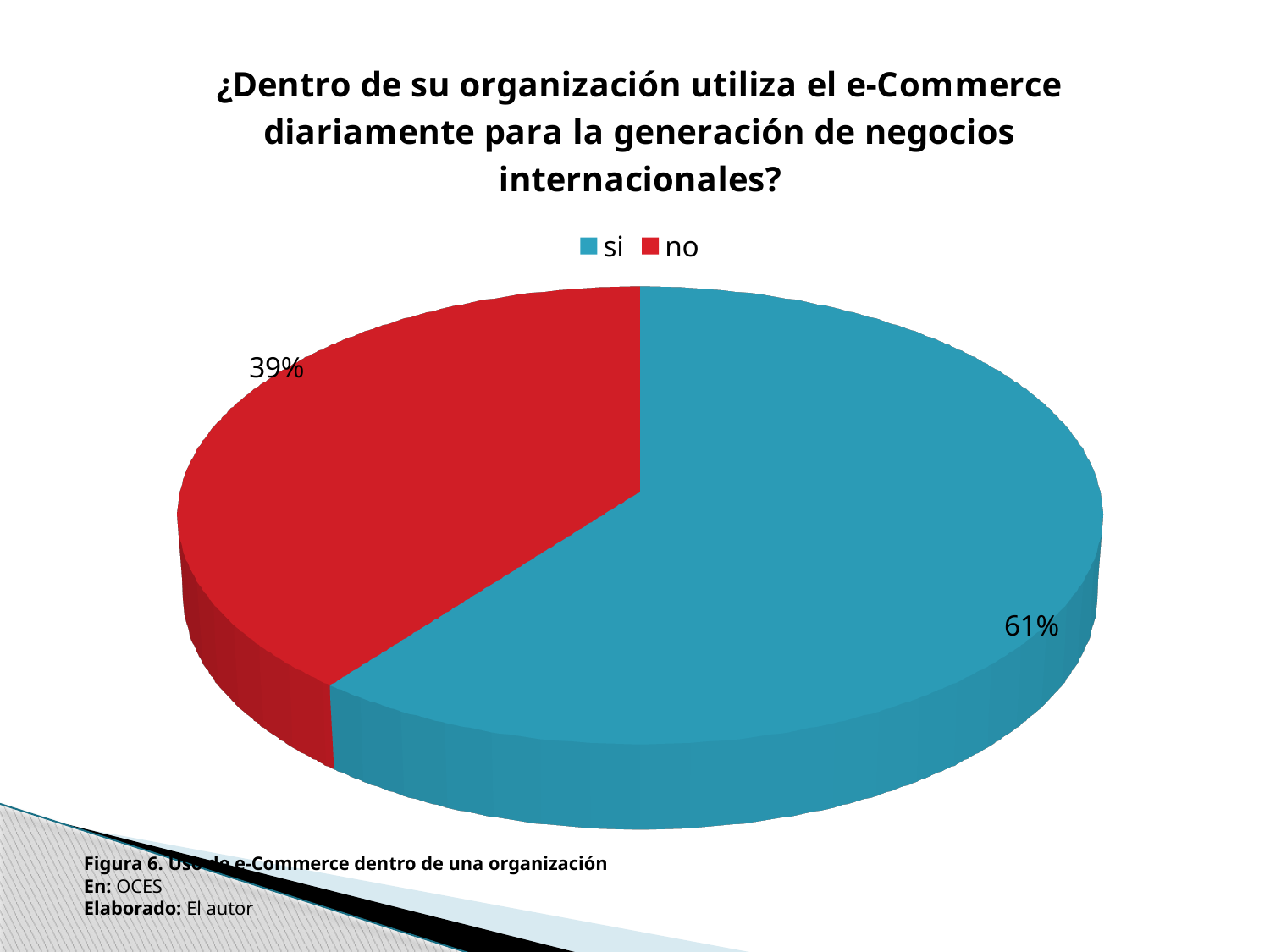
What is the title of the chart? ¿Dentro de su organización utiliza el e-Commerce diariamente para la generación de negocios internacionales? Which slice is the smallest? no What colour is the "si" slice? blue What is the difference in percentage points between the "si" and "no" slices? 22 What percentage of the pie is labelled "no"? 39% How many entries does the legend list? 2 How many slices does the pie chart have? 2 What kind of chart is shown on the slide? pie chart Which is larger, the "si" slice or the "no" slice? si What percentage of the pie is labelled "si"? 61% Which slice is the largest? si What share of the pie does the "no" slice represent? 39%